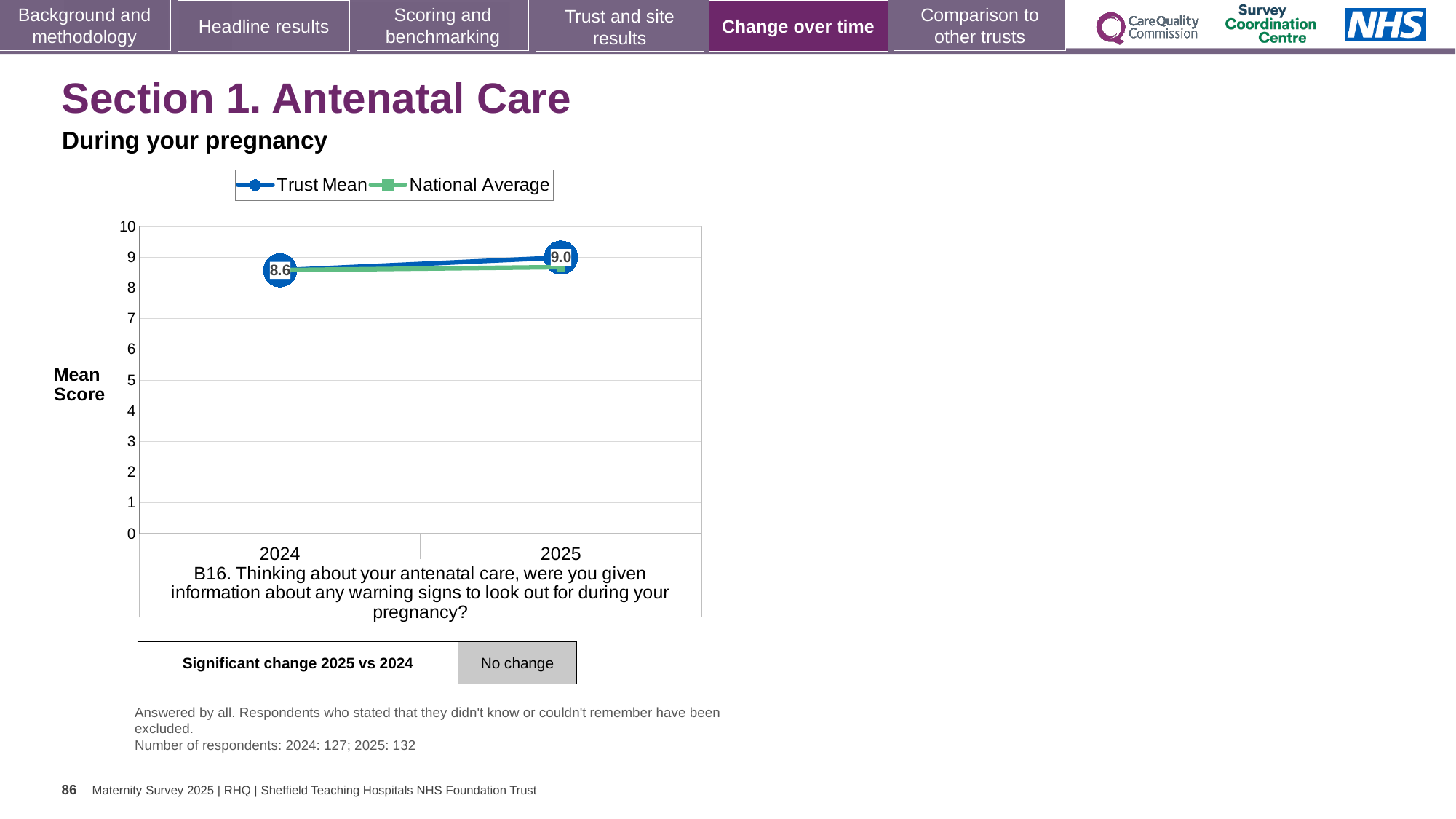
How many years are plotted on the x axis? 2 By how much did the Trust Mean change from 2024 to 2025? 0.4 How many series does the legend list? 2 What is the label on the y axis of the chart? Mean Score Is the National Average value for 2024 greater or less than 8? greater What is the Trust Mean value for 2024? 8.6 In 2025, which is larger, the Trust Mean or the National Average? Trust Mean What is the Trust Mean value for 2025? 9.0 Is the National Average value for 2025 greater or less than 5? greater In which year is the Trust Mean higher, 2024 or 2025? 2025 Does the Trust Mean rise or fall from 2024 to 2025? rise What kind of chart is shown on the slide? line chart